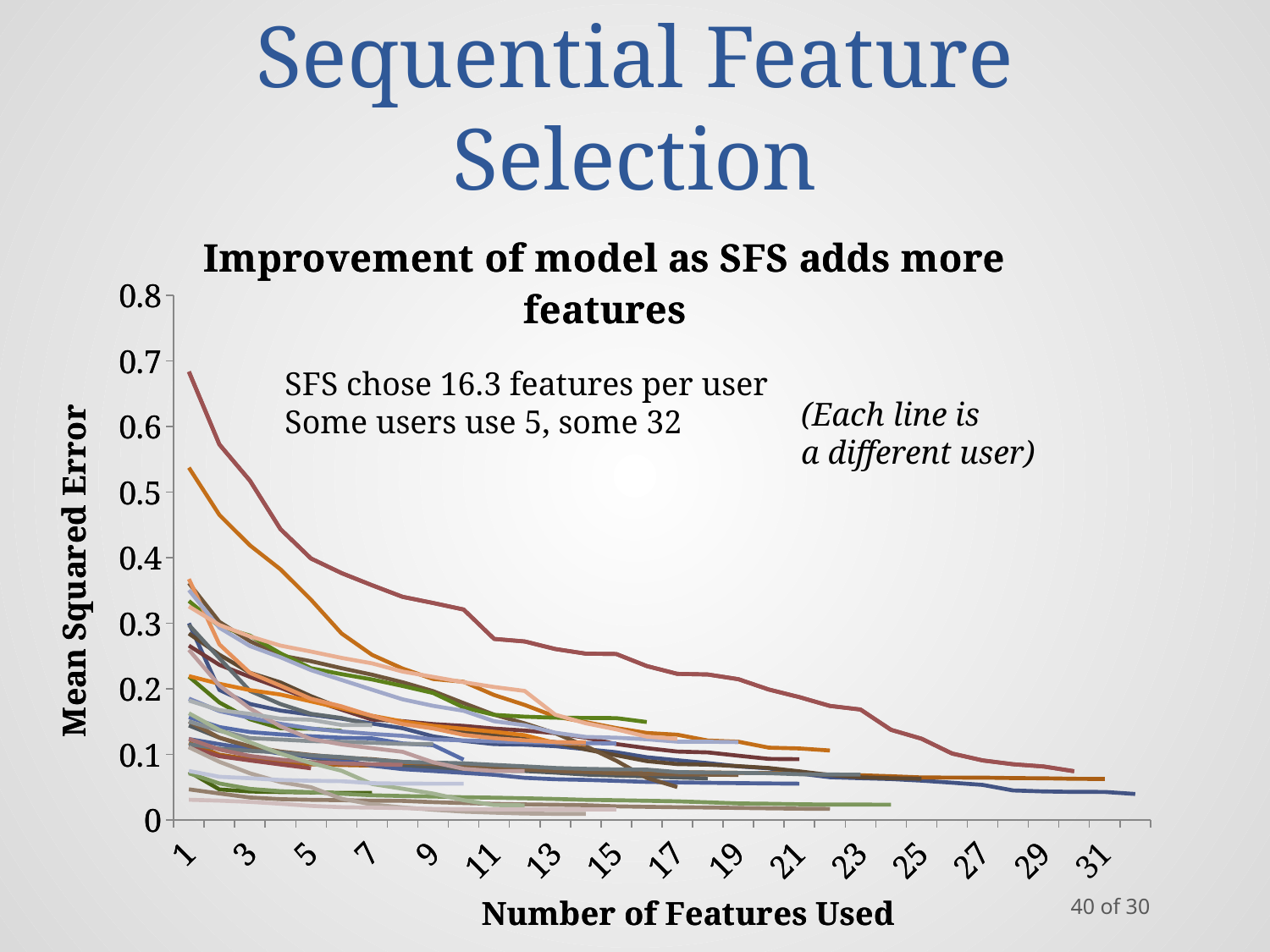
What does the y axis of the chart measure? Mean Squared Error According to the slide, how many features did SFS choose per user on average? 16.3 What kind of chart is shown on the slide? line chart Is the mean squared error of the highest line at 11 features used greater or less than 0.4? less What is the title of the chart? Improvement of model as SFS adds more features Is the mean squared error of the longest line at its final point (around 32 features) greater or less than 0.1? less Is the highest mean squared error at 1 feature used greater or less than 0.7? less As the number of features used increases, do the lines generally rise or fall? fall According to the slide, what is the largest number of features any user uses? 32